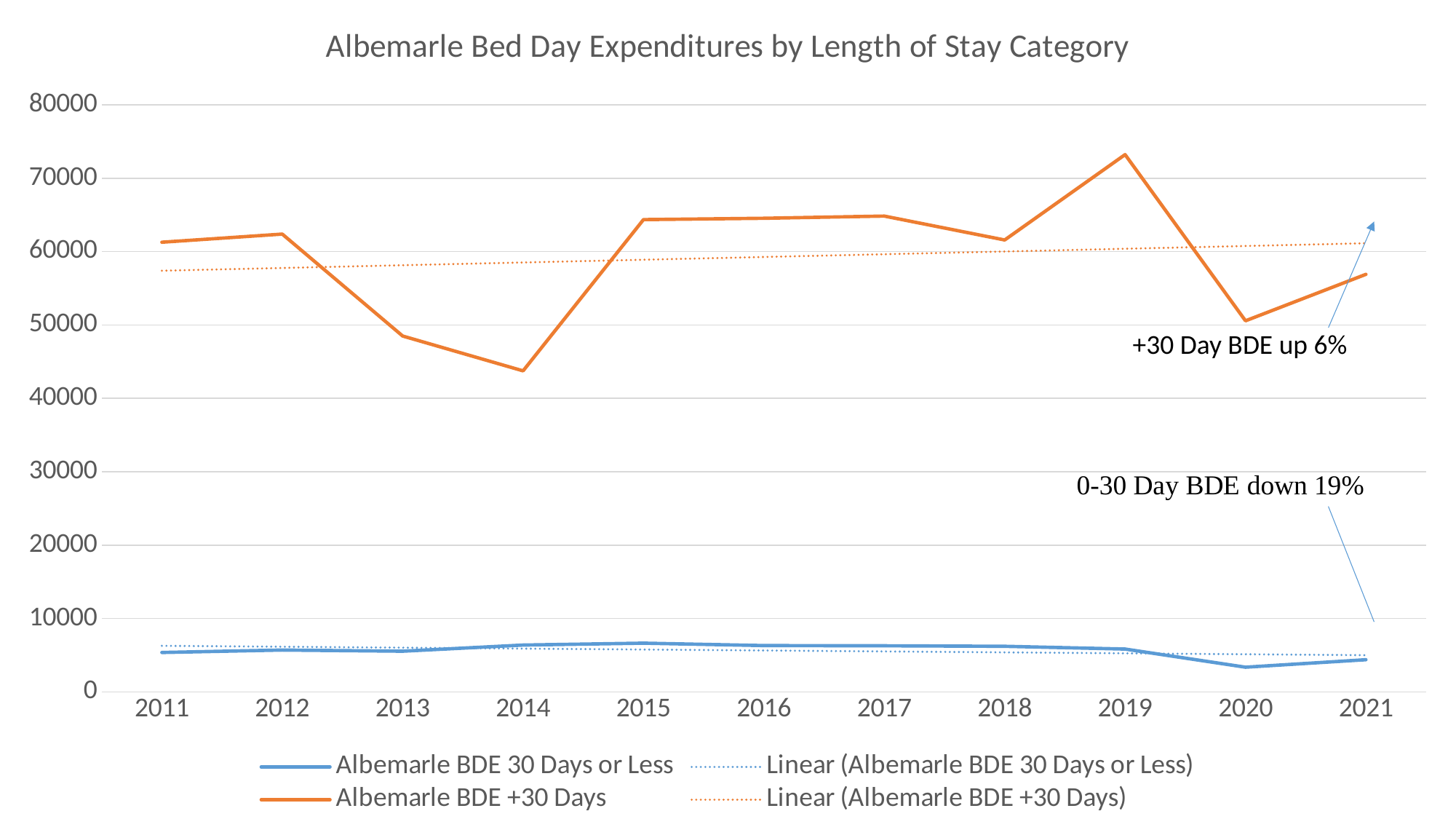
In which year is the Albemarle BDE +30 Days series at its highest? 2019 What is the title of the chart? Albemarle Bed Day Expenditures by Length of Stay Category According to the annotation on the chart, by what percentage is the +30 Day BDE up? 6% What kind of chart is shown on the slide? line chart How many years are plotted along the x axis? 11 Which is larger, the Albemarle BDE +30 Days value in 2019 or in 2020? 2019 How many entries does the legend list? 4 In which year is the Albemarle BDE +30 Days series at its lowest? 2014 Is the value for Albemarle BDE +30 Days in 2014 greater or less than 50000? less Is the value for Albemarle BDE 30 Days or Less in 2015 greater or less than 10000? less Is the value for Albemarle BDE +30 Days in 2019 greater or less than 70000? greater Does the dotted linear trendline for Albemarle BDE +30 Days rise or fall from 2011 to 2021? rise